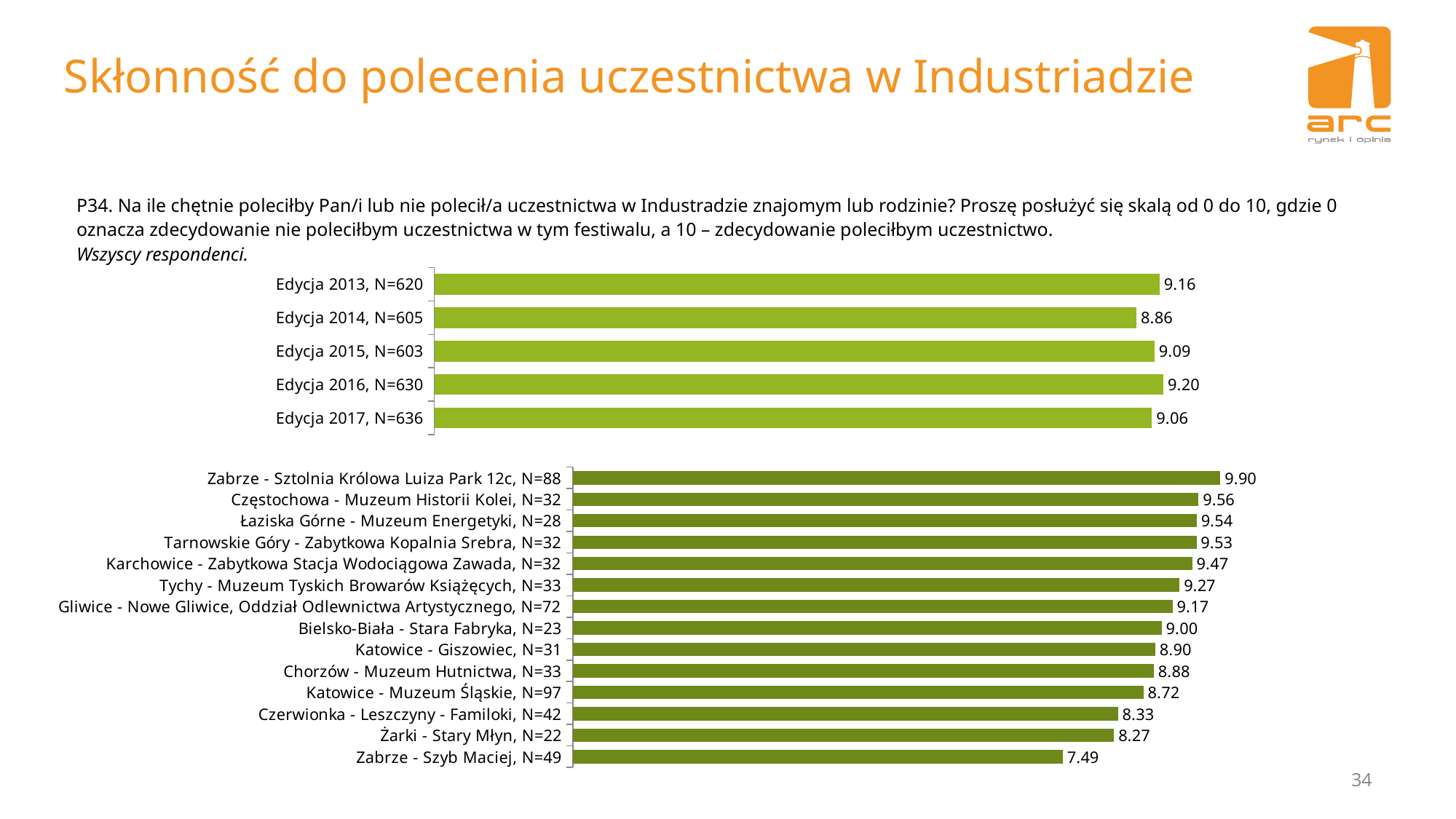
In the bottom chart (locations), what is the value for Czerwionka - Leszczyny - Familoki, N=42? 8.33 In the bottom chart (locations), how many locations are shown? 14 In the bottom chart (locations), which is larger: the value for Katowice - Giszowiec or the value for Katowice - Muzeum Śląskie? Katowice - Giszowiec In the top chart (editions), which edition has the lowest value? Edycja 2014, N=605 In the top chart (editions), what is the value for Edycja 2016, N=630? 9.20 In the bottom chart (locations), which location has the lowest value? Zabrze - Szyb Maciej, N=49 In the top chart (editions), how many editions are shown? 5 In the bottom chart (locations), what is the difference between the values for Zabrze - Sztolnia Królowa Luiza Park 12c and Zabrze - Szyb Maciej? 2.41 In the top chart (editions), what is the difference between the values for Edycja 2013 and Edycja 2014? 0.30 What kind of chart is the bottom chart (locations)? Bar chart In the bottom chart (locations), what is the value for Tychy - Muzeum Tyskich Browarów Książęcych, N=33? 9.27 In the bottom chart (locations), which location has the highest value? Zabrze - Sztolnia Królowa Luiza Park 12c, N=88